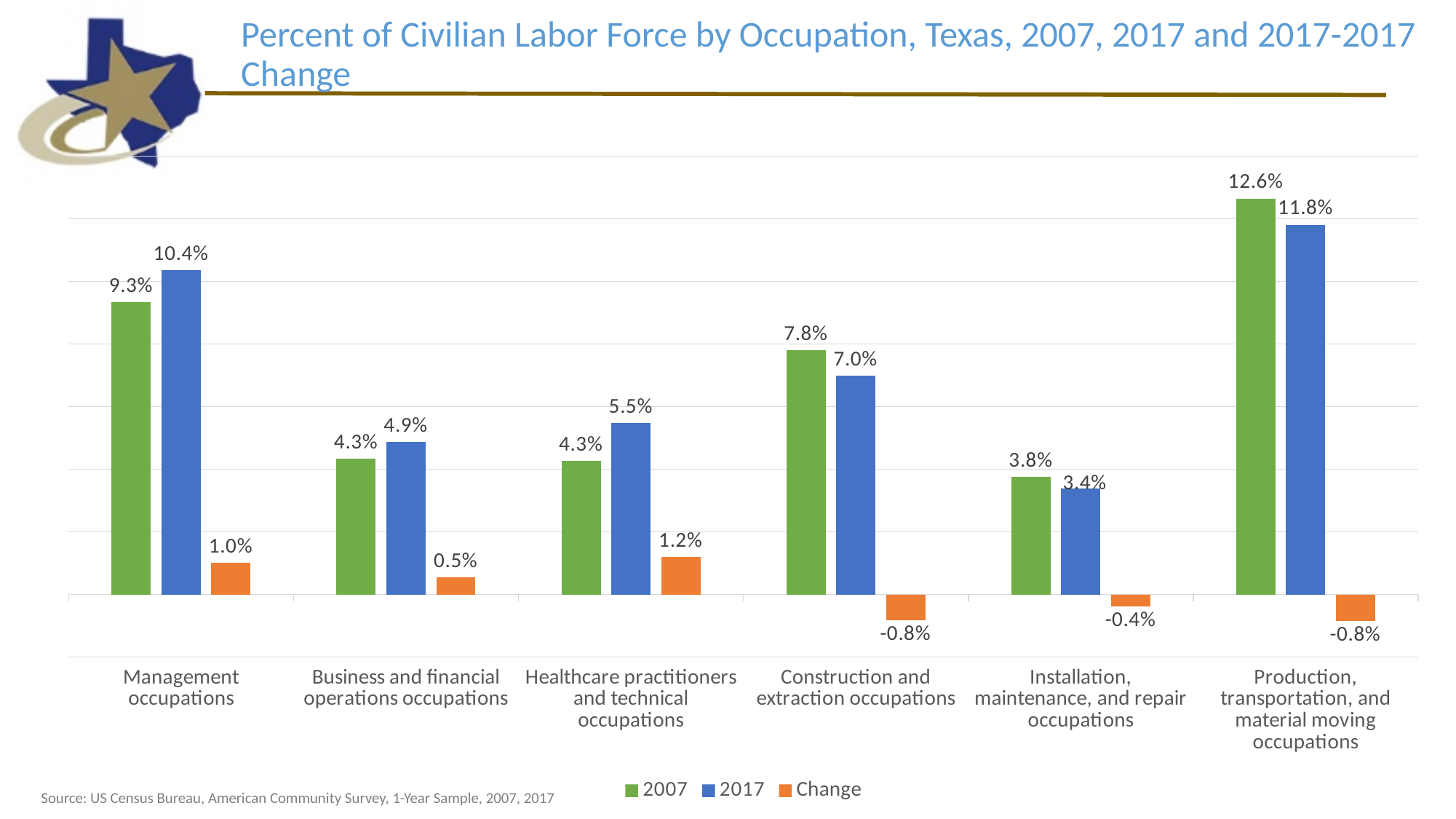
What is the 2007 value for Construction and extraction occupations? 7.8% What is the difference between the 2017 and 2007 values for Healthcare practitioners and technical occupations? 1.2% Which occupation category has the lowest 2007 value? Installation, maintenance, and repair occupations What is the Change value for Installation, maintenance, and repair occupations? -0.4% Which occupation category has the highest 2017 value? Production, transportation, and material moving occupations Which is larger for Construction and extraction occupations, the 2007 value or the 2017 value? 2007 What colour are the bars for the Change series? Orange How many series does the legend list? 3 How many occupation categories are shown on the x axis? 6 What is the 2017 value for Management occupations? 10.4% Which occupation category has the largest Change value? Healthcare practitioners and technical occupations What kind of chart is shown on the slide? Bar chart